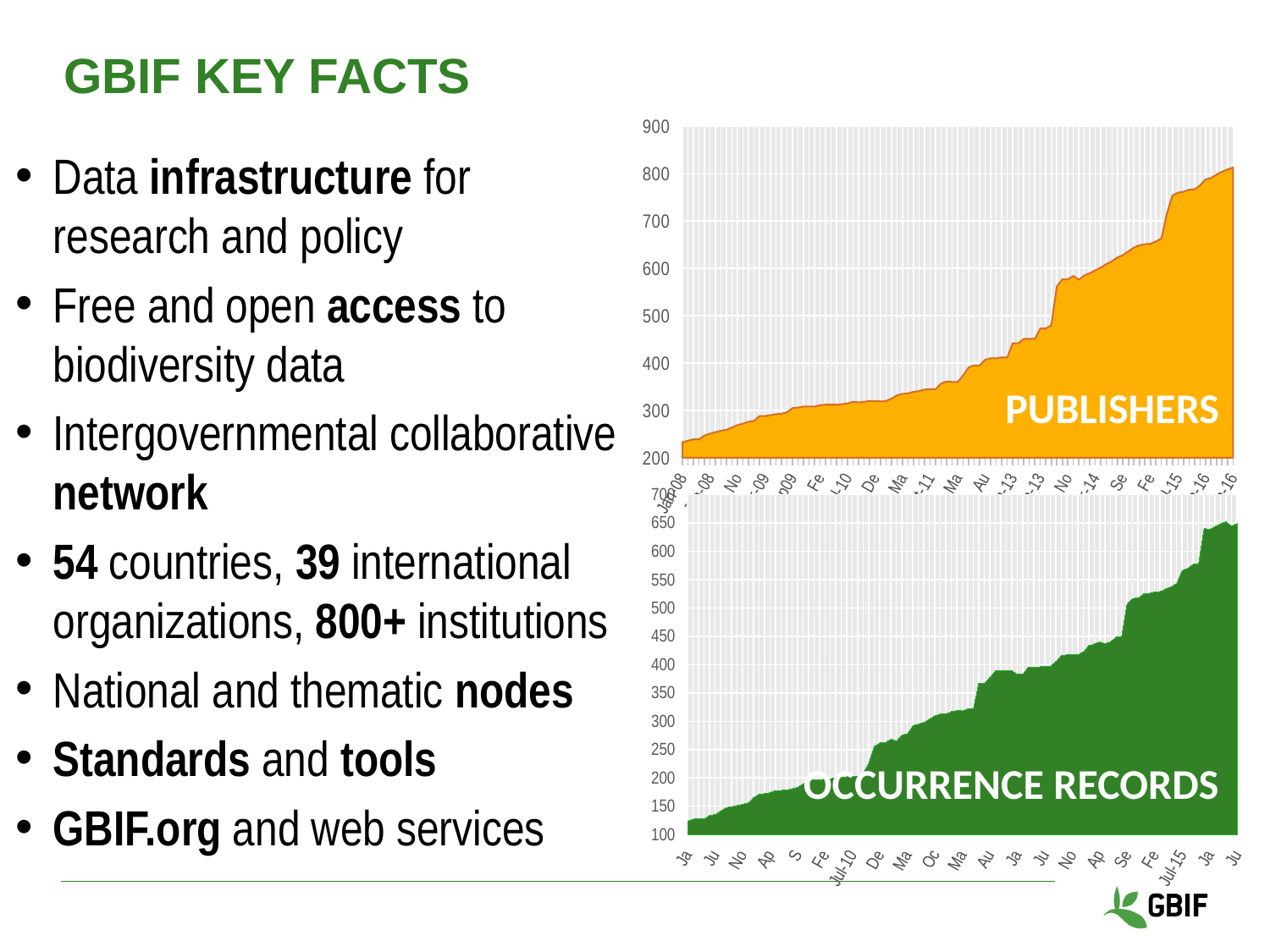
What kind of chart is the PUBLISHERS chart? area chart In the PUBLISHERS chart, do the values rise or fall over time along the x axis? rise In the OCCURRENCE RECORDS chart, is the value at the end of the series greater or less than 600? greater What is the highest value shown on the y axis of the PUBLISHERS chart? 900 In the PUBLISHERS chart, is the value at the start of the series (Jan-08) greater or less than 300? less In the PUBLISHERS chart, is the value at the end of the series (2016) greater or less than 700? greater In the OCCURRENCE RECORDS chart, do the values rise or fall over time along the x axis? rise What kind of chart is the OCCURRENCE RECORDS chart? area chart What colour is the filled area in the OCCURRENCE RECORDS chart? green